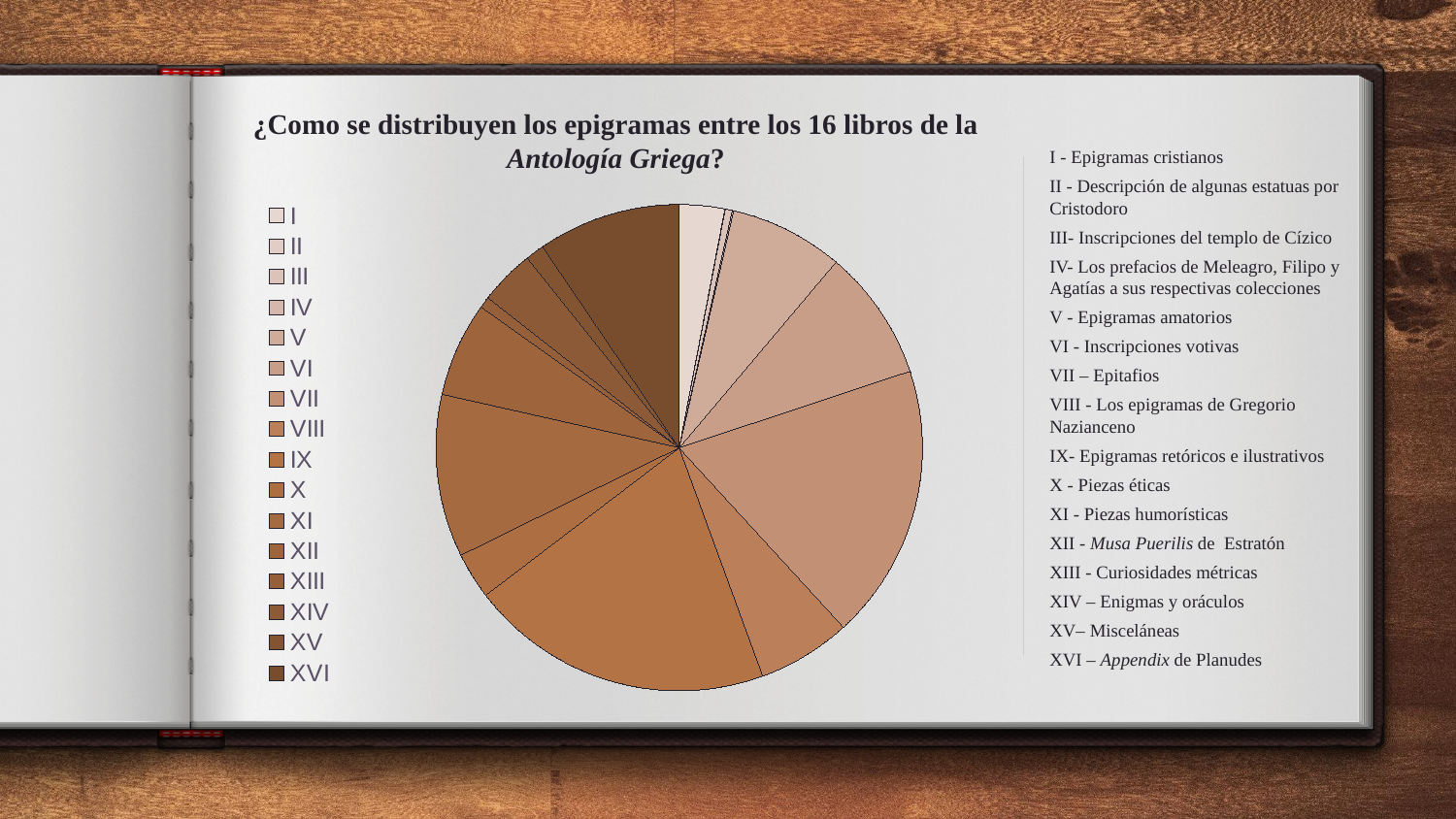
What is the title of the chart on the slide? ¿Como se distribuyen los epigramas entre los 16 libros de la Antología Griega? Which slice is larger in the pie chart, the one for I or the one for VII? VII What kind of chart is shown on the slide? pie chart How many categories (books) does the pie chart's legend list? 16 What is the first entry in the chart's legend? I Which slice is larger in the pie chart, the one for II or the one for XVI? XVI Which slice is larger in the pie chart, the one for III or the one for IX? IX